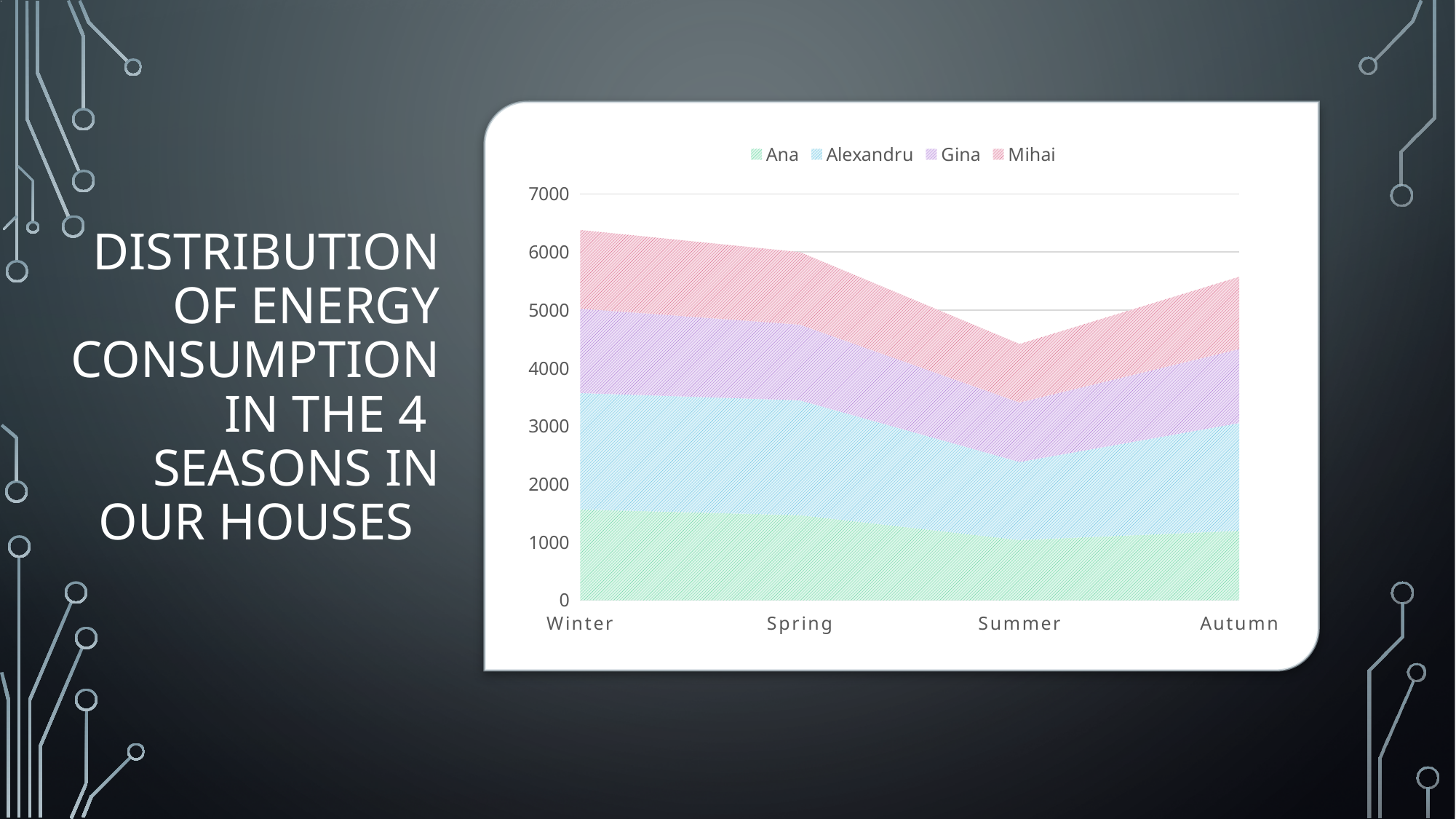
How many seasons (categories) are plotted along the x axis? 4 Is the value for Ana in Summer greater or less than 1500? less Is the value for Ana in Winter greater or less than 1000? greater Is the total stacked value for Winter greater or less than 6000? greater Which series are listed in the legend? Ana, Alexandru, Gina, Mihai Which season has the lowest total stacked energy consumption? Summer Does the total stacked value rise or fall from Winter to Summer? Fall Is Ana's value larger in Winter or in Summer? Winter Which season has the highest total stacked energy consumption? Winter What kind of chart is shown on the slide? Stacked area chart How many series does the legend list? 4